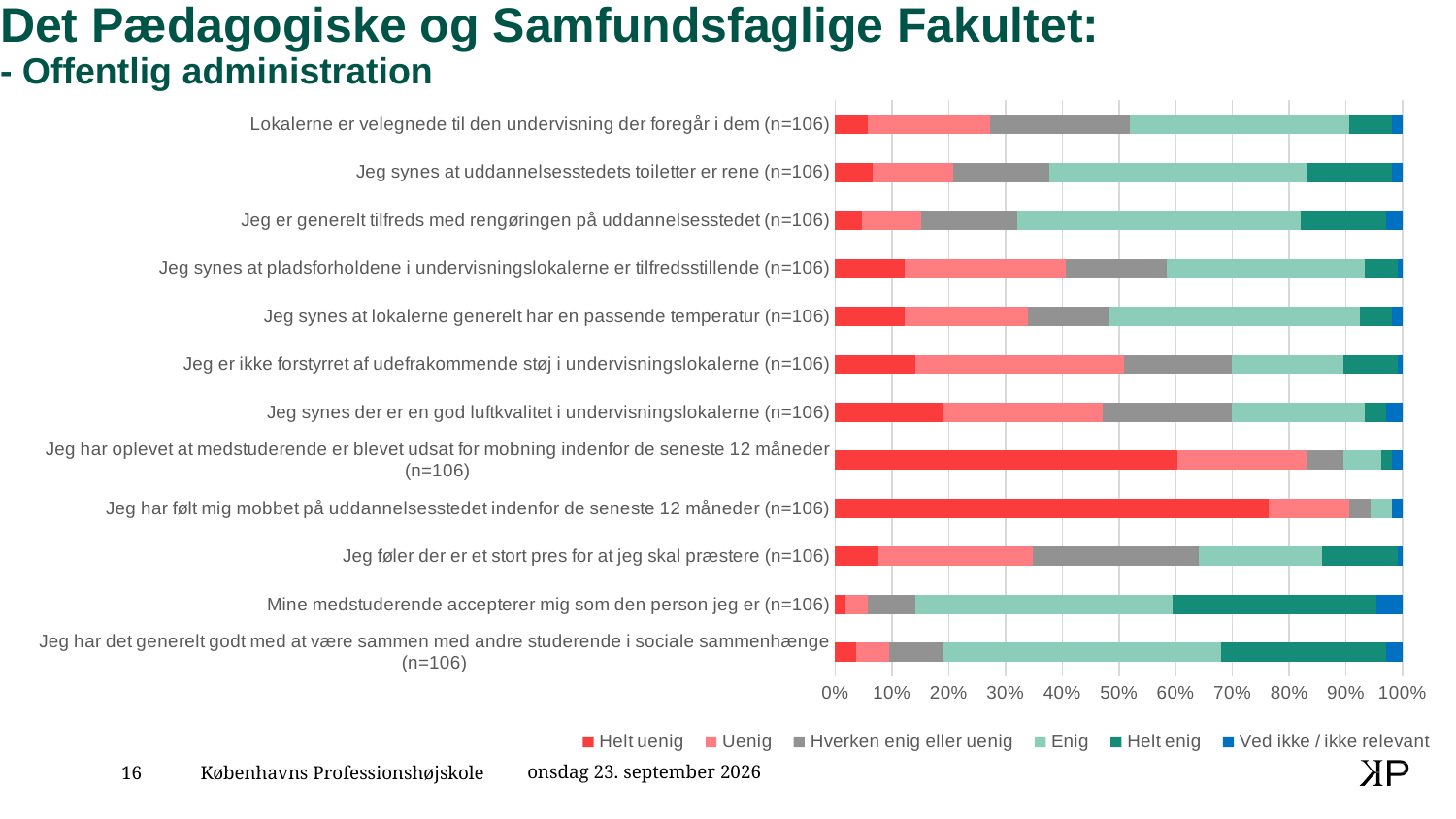
Which statement has the smallest 'Helt uenig' segment? Mine medstuderende accepterer mig som den person jeg er (n=106) Which statement has the largest 'Helt uenig' segment? Jeg har følt mig mobbet på uddannelsesstedet indenfor de seneste 12 måneder (n=106) What kind of chart is shown on the slide? Stacked bar chart How many series does the legend list? 6 Which statement has the largest 'Helt enig' segment? Mine medstuderende accepterer mig som den person jeg er (n=106) Is the 'Helt uenig' share for 'Jeg har følt mig mobbet på uddannelsesstedet indenfor de seneste 12 måneder' greater or less than 70%? greater Is the 'Helt uenig' share for 'Jeg har oplevet at medstuderende er blevet udsat for mobning indenfor de seneste 12 måneder' greater or less than 50%? greater Is the 'Helt uenig' share for 'Lokalerne er velegnede til den undervisning der foregår i dem' greater or less than 10%? less What is the first entry in the chart legend? Helt uenig Which has a larger 'Helt uenig' share: 'Jeg synes der er en god luftkvalitet i undervisningslokalerne' or 'Jeg synes at lokalerne generelt har en passende temperatur'? Jeg synes der er en god luftkvalitet i undervisningslokalerne How many statements (categories) are plotted in the chart? 12 What sample size (n) is shown for each statement in the chart? n=106